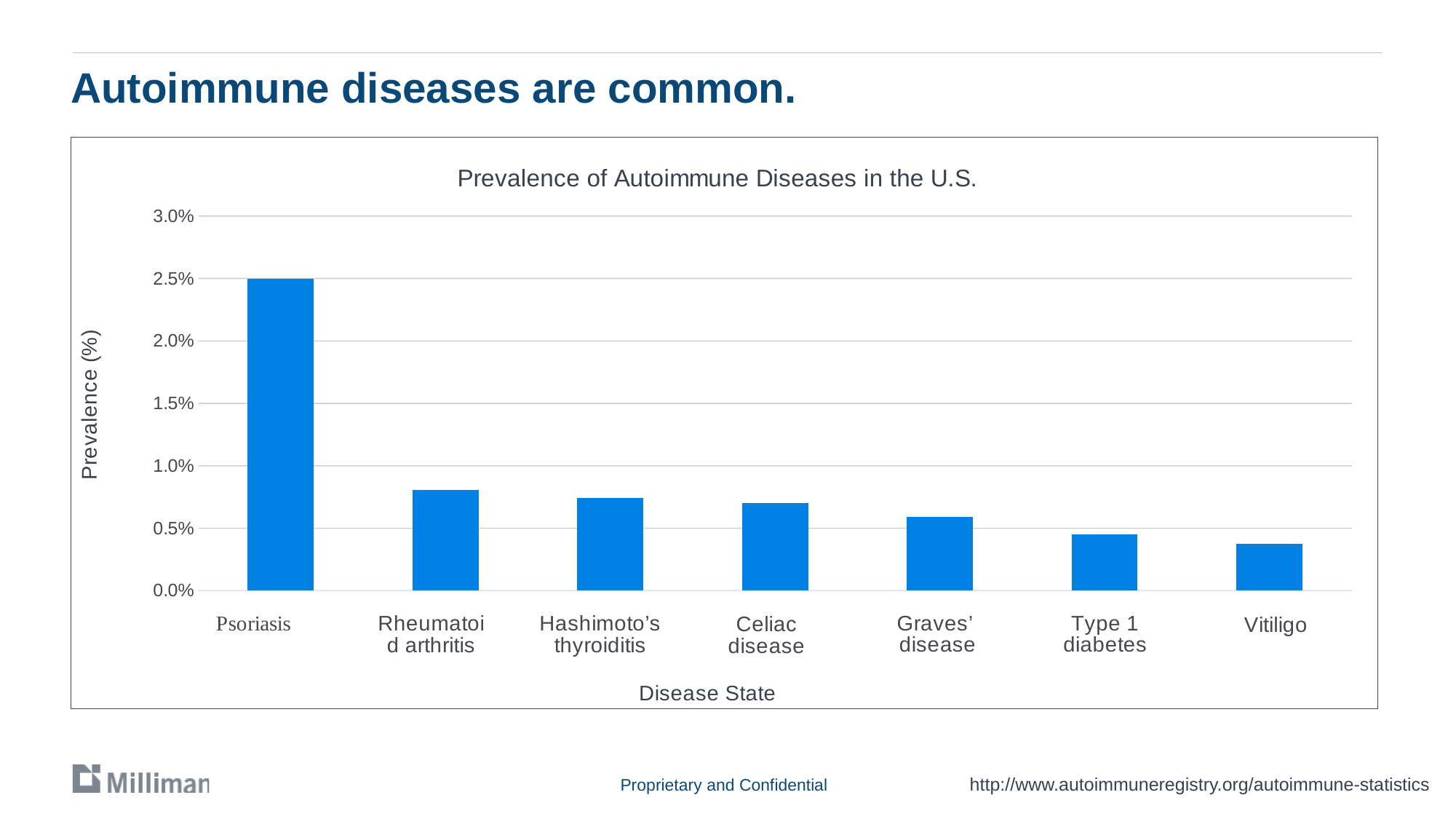
Is the value for Vitiligo greater or less than 0.5%? less Which disease state has the highest prevalence? Psoriasis What is the prevalence shown for Psoriasis? 2.5% Is the value for Rheumatoid arthritis greater or less than 1.0%? less Which disease state has the lowest prevalence? Vitiligo Which has a higher prevalence, Hashimoto's thyroiditis or Graves' disease? Hashimoto's thyroiditis What is the label of the vertical axis? Prevalence (%) How many disease states are plotted in the chart? 7 What type of chart is shown on the slide? Bar chart Is the value for Graves' disease greater or less than 0.5%? greater Do the prevalence values rise or fall moving from left to right across the disease states? Fall What is the title of the chart? Prevalence of Autoimmune Diseases in the U.S.